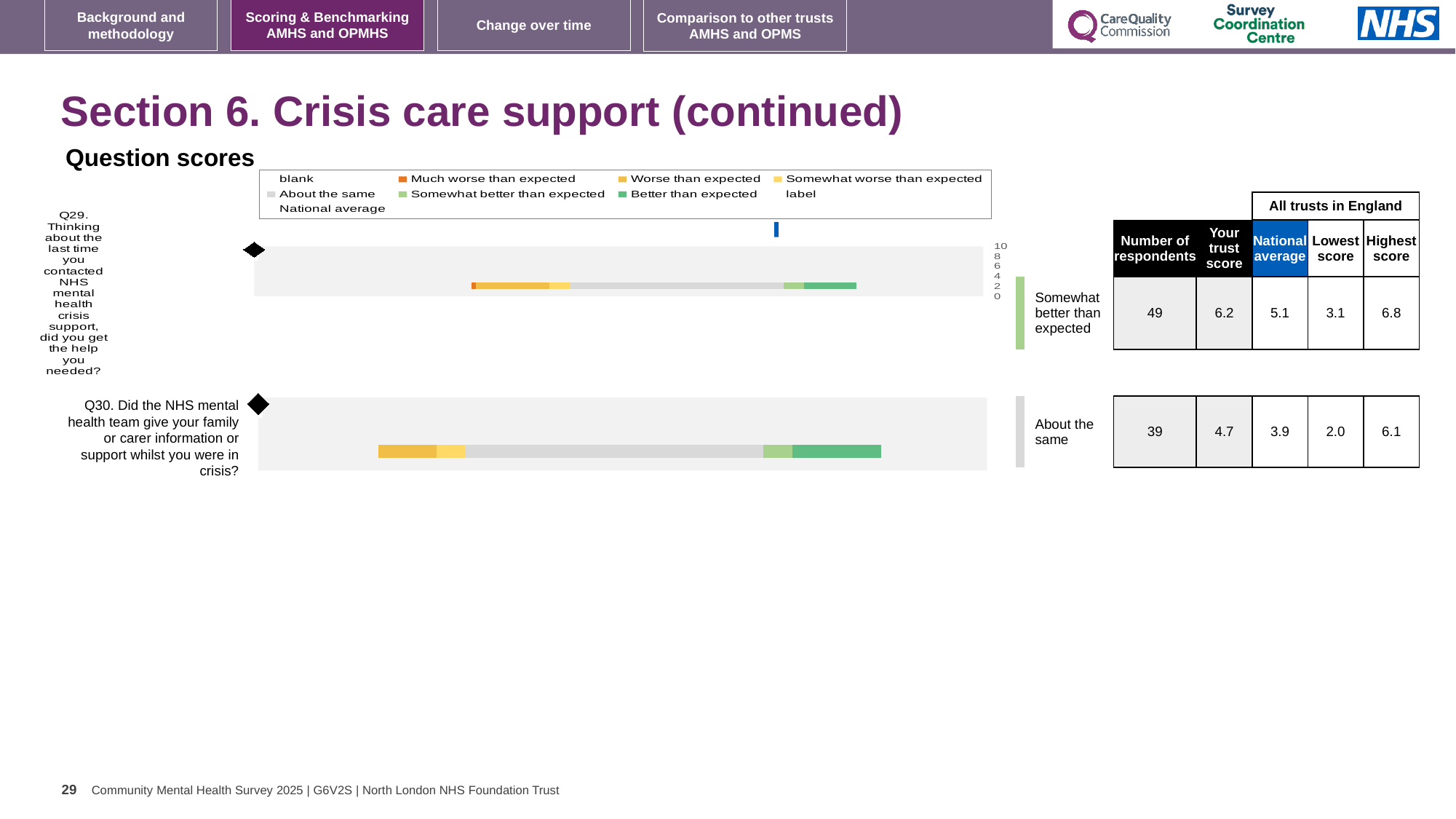
How many questions are plotted in the chart? 2 What is the trust score for Q30 shown in the table next to the chart? 4.7 What kind of chart is shown under 'Question scores'? bar chart What is the highest score among all trusts in England for Q29? 6.8 What is the number of respondents for Q30? 39 What is the trust score for Q29 shown in the table next to the chart? 6.2 What is the lowest score among all trusts in England for Q30? 2.0 What is the difference between the trust score and the national average for Q30? 0.8 What is the national average for Q29? 5.1 What benchmark category is Q30 assigned to in the chart? About the same What is the difference between the trust score and the national average for Q29? 1.1 Which question has the higher trust score, Q29 or Q30? Q29